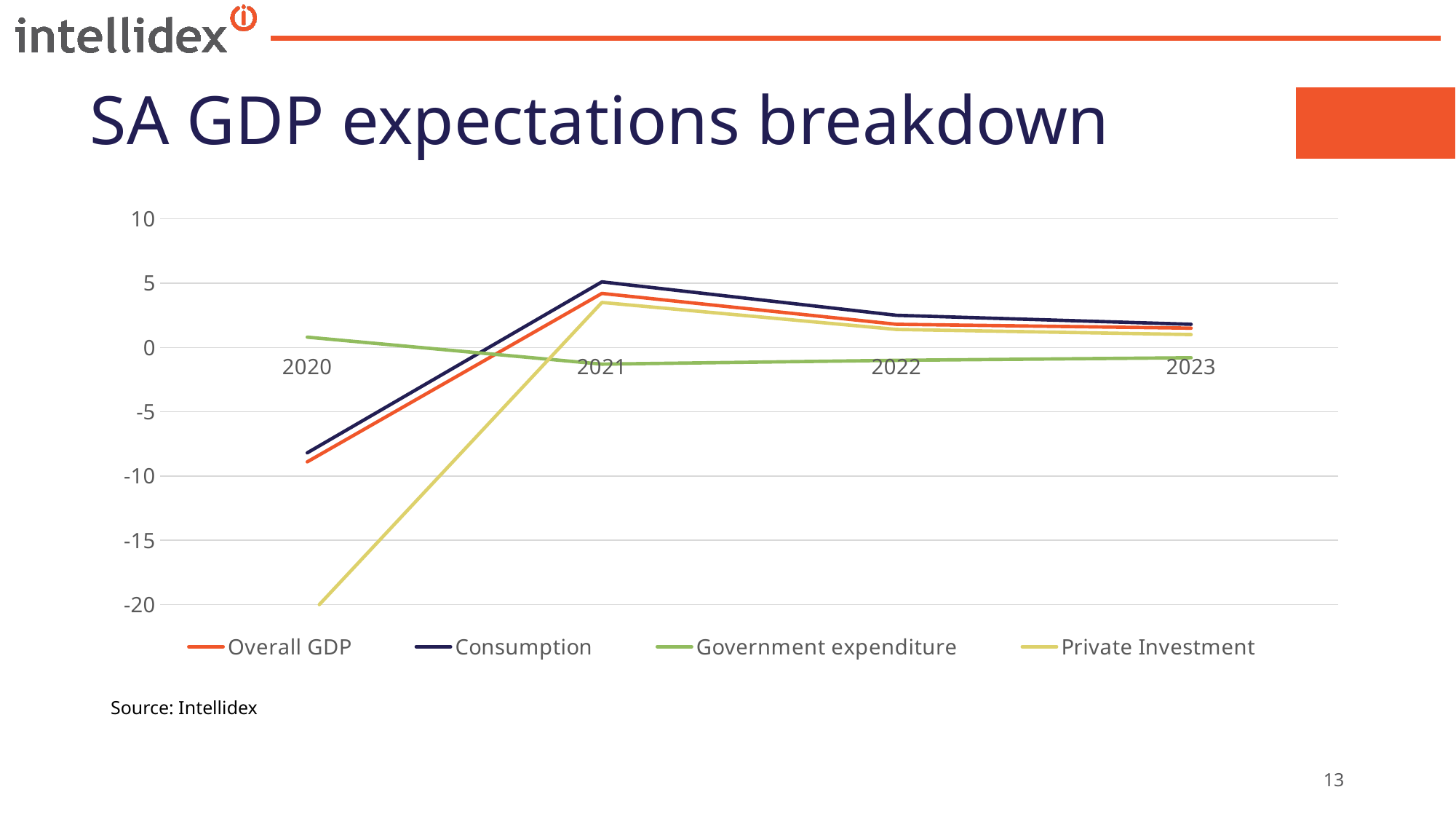
Does the Government expenditure line rise or fall from 2020 to 2021? Fall What kind of chart is shown on the slide? Line chart How many series does the legend list? 4 Is the value for Overall GDP in 2020 greater or less than -5? less In 2020, which is larger: Government expenditure or Overall GDP? Government expenditure Does the Overall GDP line rise or fall from 2021 to 2023? Fall Is the value for Consumption in 2021 greater or less than 0? greater Is the value for Private Investment in 2020 greater or less than -15? less Which series has the highest value in 2020? Government expenditure Which series has the lowest value in 2020? Private Investment Which series has the highest value in 2021? Consumption How many years are plotted along the x axis? 4